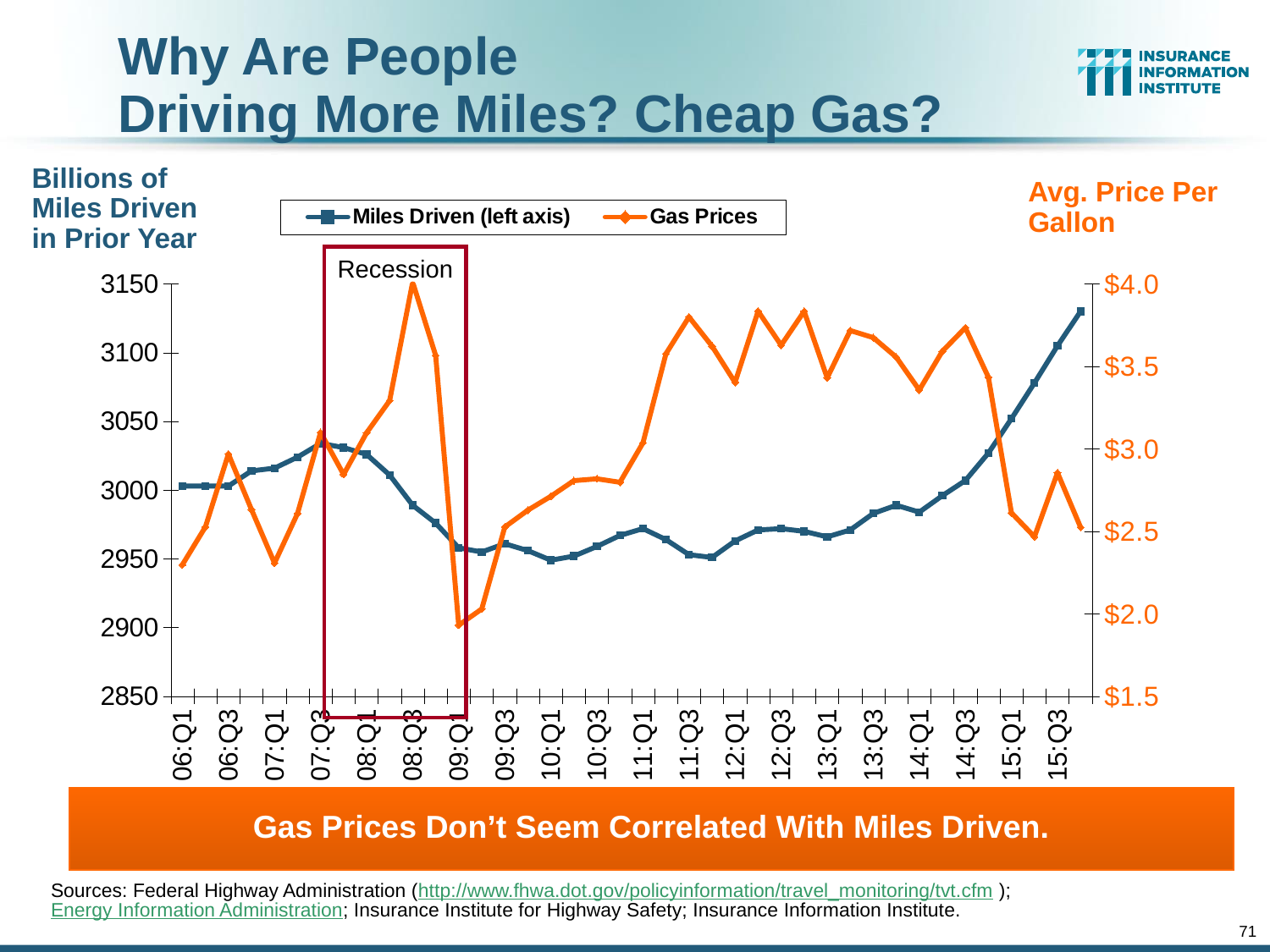
Is the Gas Prices value at 12:Q1 greater or less than $3.0? greater Is the Gas Prices value at 09:Q1 greater or less than $2.5? less Is the Miles Driven value at 15:Q1 greater or less than 3000? greater What kind of chart is shown on the slide? Line chart How many series does the chart's legend list? 2 Which is larger, the Miles Driven value at 15:Q1 or at 10:Q1? 15:Q1 What are the two series named in the chart's legend? Miles Driven (left axis) and Gas Prices Do Miles Driven rise or fall from 13:Q1 to 15:Q3? Rise In which quarter do Gas Prices reach their lowest point on the chart? 09:Q1 What period is marked by the red box on the chart? Recession In which quarter do Gas Prices reach their highest point on the chart? 08:Q3